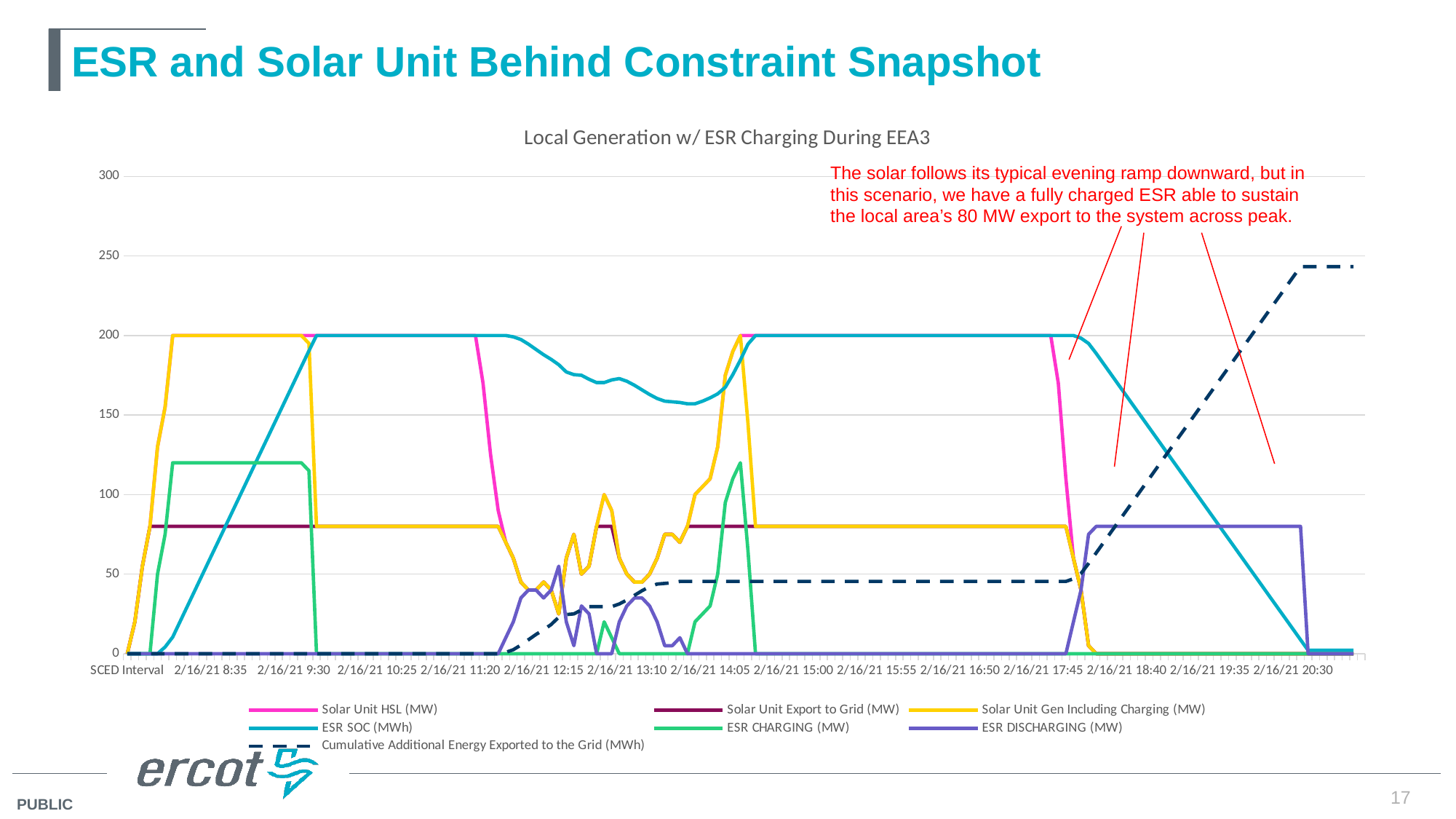
Which series is drawn as a dashed line? Cumulative Additional Energy Exported to the Grid (MWh) At 2/16/21 18:40, which is larger: ESR SOC (MWh) or ESR DISCHARGING (MW)? ESR SOC (MWh) Does Cumulative Additional Energy Exported to the Grid (MWh) rise or fall between 2/16/21 17:45 and 2/16/21 20:30? rise What is the title of the chart? Local Generation w/ ESR Charging During EEA3 What kind of chart is shown on the slide? line chart Is the value of ESR CHARGING (MW) at 2/16/21 8:35 greater or less than 100? greater Is the value of ESR DISCHARGING (MW) at 2/16/21 19:35 greater or less than 100? less Is the value of Cumulative Additional Energy Exported to the Grid (MWh) at 2/16/21 20:30 greater or less than 200? greater How many series does the legend list? 7 Does ESR SOC (MWh) rise or fall between 2/16/21 17:45 and 2/16/21 20:30? fall What is the value of Solar Unit HSL (MW) at 2/16/21 10:25? 200 What is the value of ESR SOC (MWh) at 2/16/21 15:00? 200